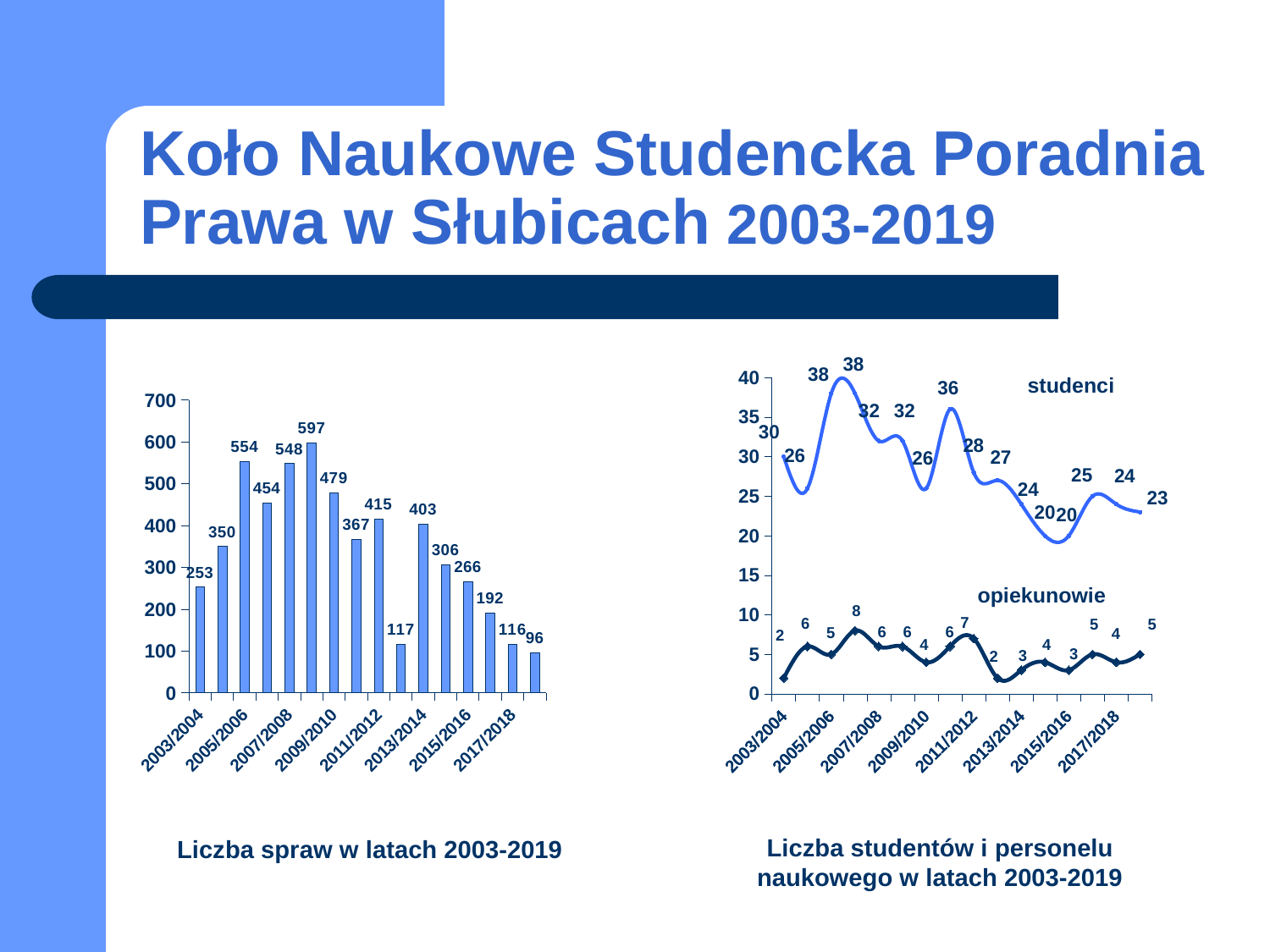
In the right chart, what is the value of the 'studenci' series for 2005/2006? 38 In the left chart 'Liczba spraw w latach 2003-2019', which is larger, the value for 2003/2004 or the value for 2017/2018? 2003/2004 In the left chart 'Liczba spraw w latach 2003-2019', what is the lowest value shown? 96 In the left chart 'Liczba spraw w latach 2003-2019', what is the difference between the values for 2005/2006 and 2007/2008? 6 In the left chart 'Liczba spraw w latach 2003-2019', what is the highest value shown? 597 What kind of chart is the right chart, 'Liczba studentów i personelu naukowego w latach 2003-2019'? line chart In the left chart 'Liczba spraw w latach 2003-2019', how many bars are plotted? 16 In the right chart, what is the highest value of the 'opiekunowie' series? 8 In the left chart 'Liczba spraw w latach 2003-2019', what is the value for 2013/2014? 403 What kind of chart is the left chart, 'Liczba spraw w latach 2003-2019'? bar chart In the left chart 'Liczba spraw w latach 2003-2019', what is the value for 2003/2004? 253 In the right chart, how many series are plotted? 2